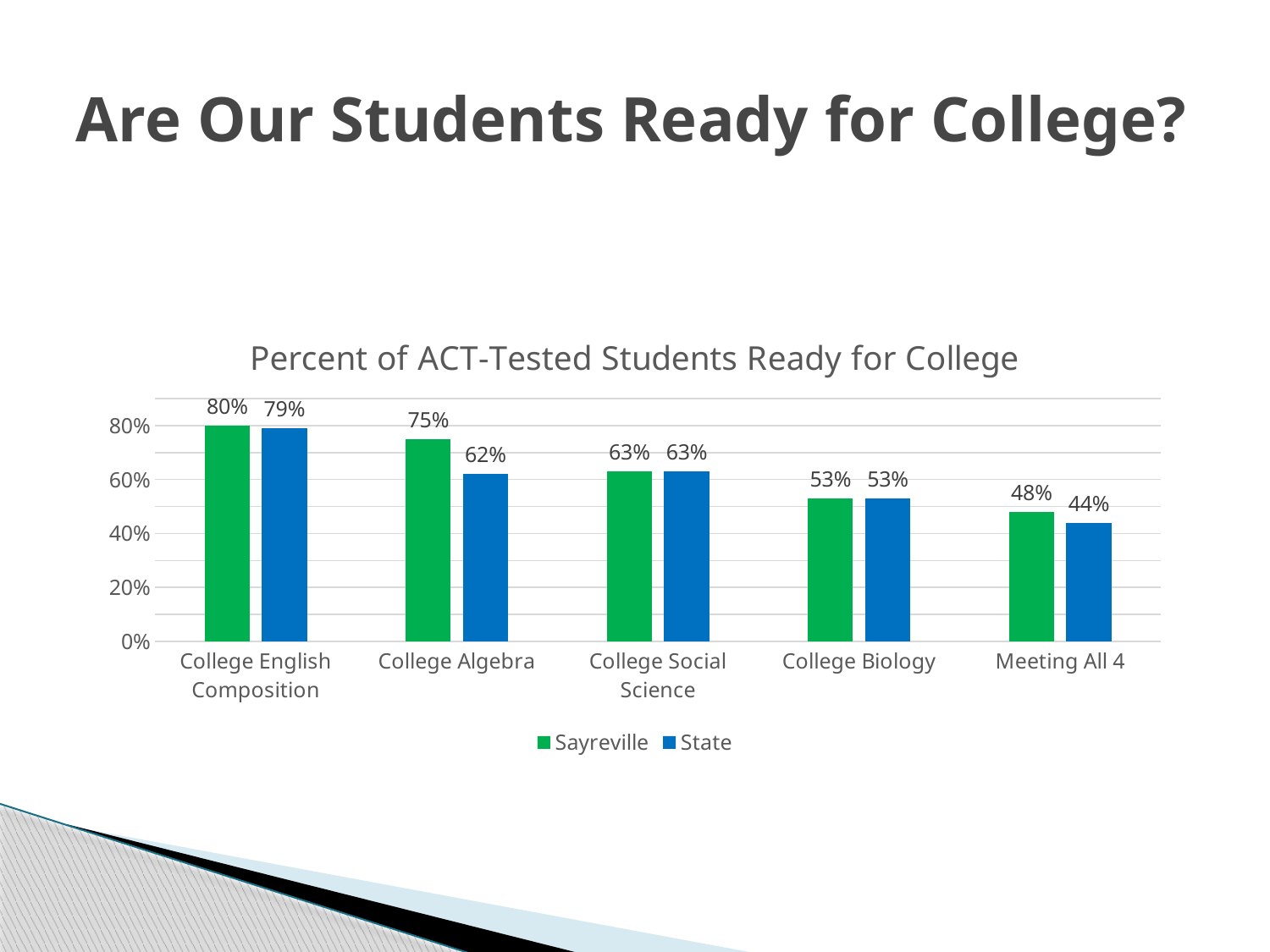
What is the State value for College English Composition? 79% What is the title of the chart? Percent of ACT-Tested Students Ready for College How many series does the legend list? 2 Which category has the highest Sayreville value? College English Composition What kind of chart is shown on the slide? Bar chart Which is larger for Meeting All 4, the Sayreville value or the State value? Sayreville Which category has the lowest State value? Meeting All 4 How many categories are shown on the x axis? 5 Do the Sayreville values rise or fall from left to right across the categories? Fall What is the difference between the Sayreville and State values for College Algebra? 13% What is the State value for Meeting All 4? 44% What is the Sayreville value for College Algebra? 75%